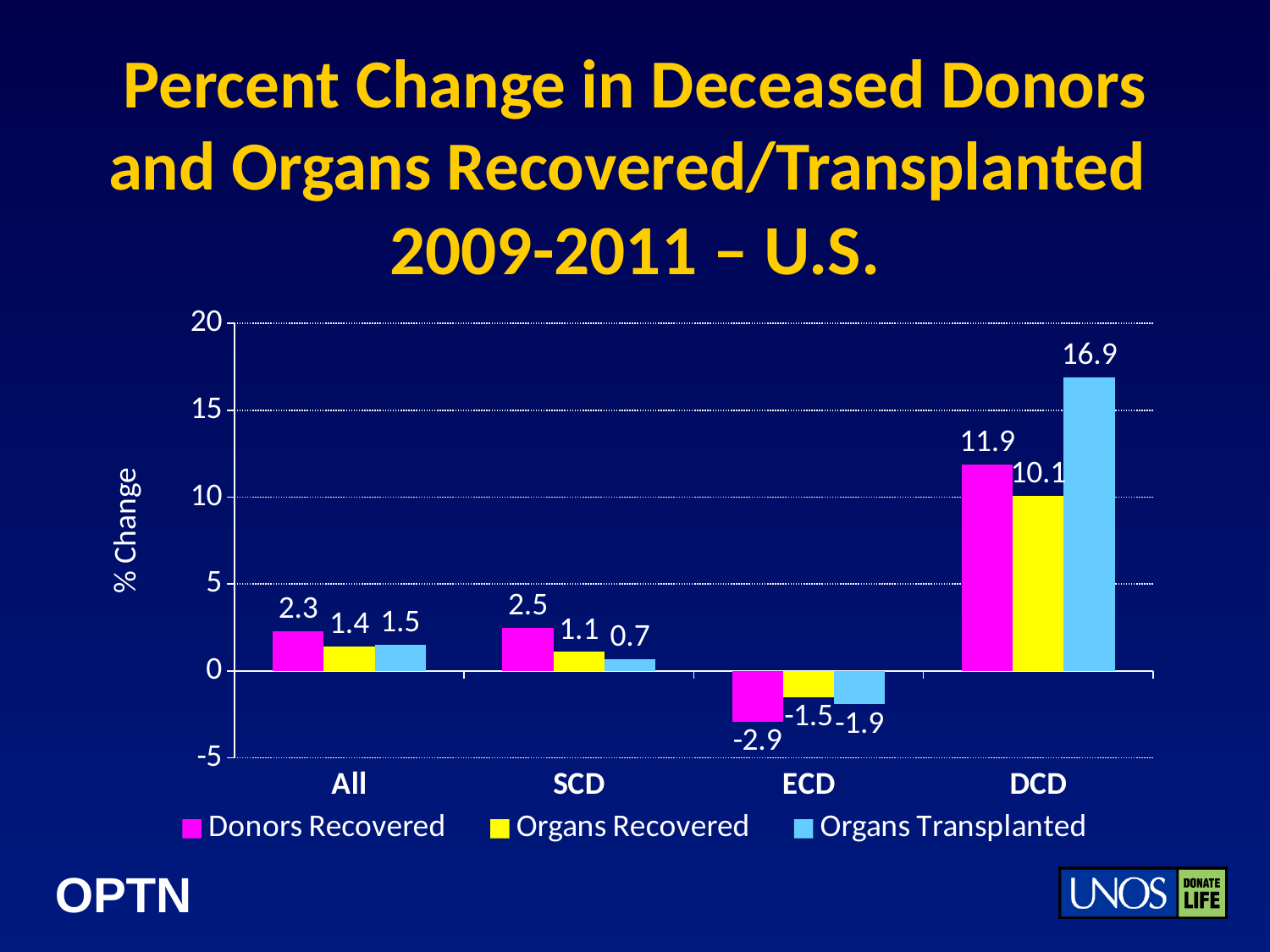
What is the value for Donors Recovered in the DCD category? 11.9 What kind of chart is shown on the slide? Bar chart Which category has the lowest Donors Recovered value? ECD What is the value for Organs Transplanted in the ECD category? -1.9 What is the value for Organs Recovered in the SCD category? 1.1 What is the difference between Organs Transplanted and Donors Recovered in the DCD category? 5.0 Which category has the highest Organs Transplanted value? DCD Which is larger in the All category: Donors Recovered or Organs Transplanted? Donors Recovered What colour represents the Organs Recovered series? Yellow How many series does the legend list? 3 How many categories are shown on the x axis? 4 Is the value for Organs Transplanted in the DCD category greater or less than 15? greater